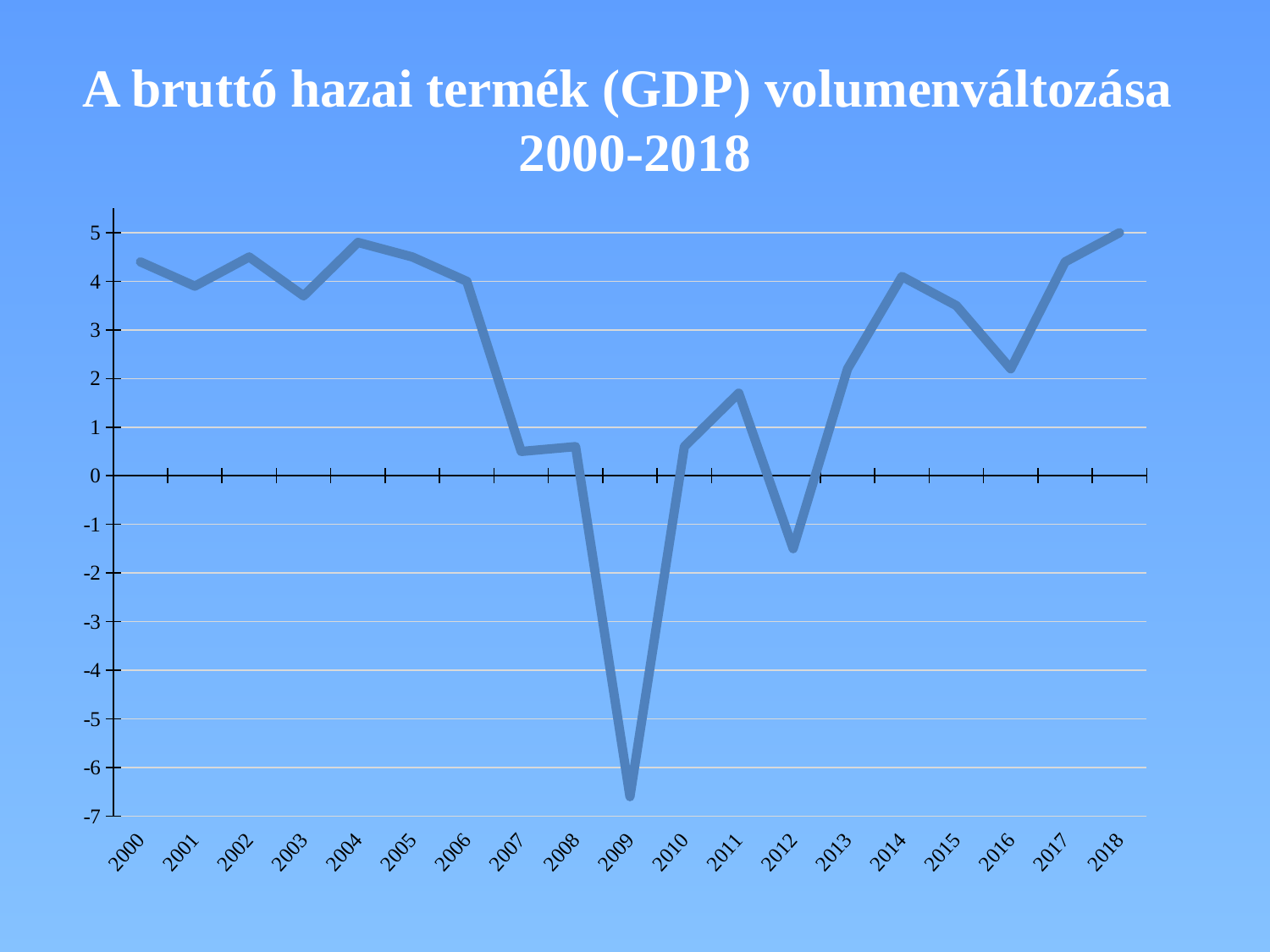
What kind of chart is shown on the slide? line chart Do the values rise or fall from 2006 to 2009? fall Is the value for 2007 greater or less than 1? less Which is larger, the value for 2014 or the value for 2015? 2014 Which year has the lowest GDP volume change? 2009 Which is larger, the value for 2009 or the value for 2012? 2012 Is the value for 2012 greater or less than -1? less Is the value for 2004 greater or less than 4? greater What is the title of the chart? A bruttó hazai termék (GDP) volumenváltozása 2000-2018 How many years are plotted on the x axis? 19